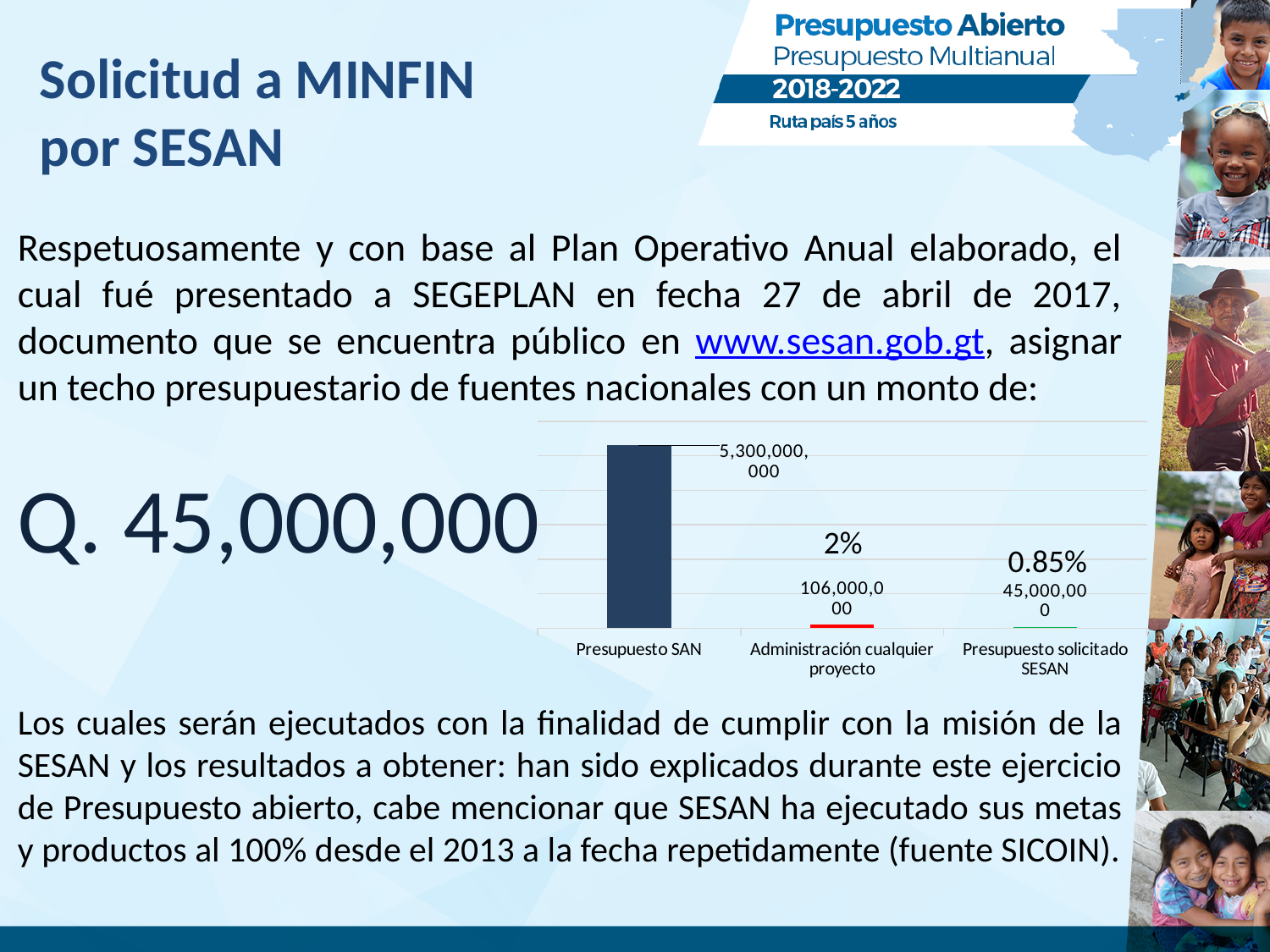
What is the value for Presupuesto SAN? 5,300,000,000 How many categories does the chart show? 3 What is the value for Presupuesto solicitado SESAN? 45,000,000 Do the values rise or fall from left to right across the categories? fall Which is larger, Administración cualquier proyecto or Presupuesto solicitado SESAN? Administración cualquier proyecto Which category has the lowest value? Presupuesto solicitado SESAN What kind of chart is shown on the slide? bar chart What percentage is shown above the Administración cualquier proyecto bar? 2% What is the value for Administración cualquier proyecto? 106,000,000 What is the difference between Administración cualquier proyecto and Presupuesto solicitado SESAN? 61,000,000 What percentage is shown above the Presupuesto solicitado SESAN bar? 0.85% Which category has the highest value? Presupuesto SAN